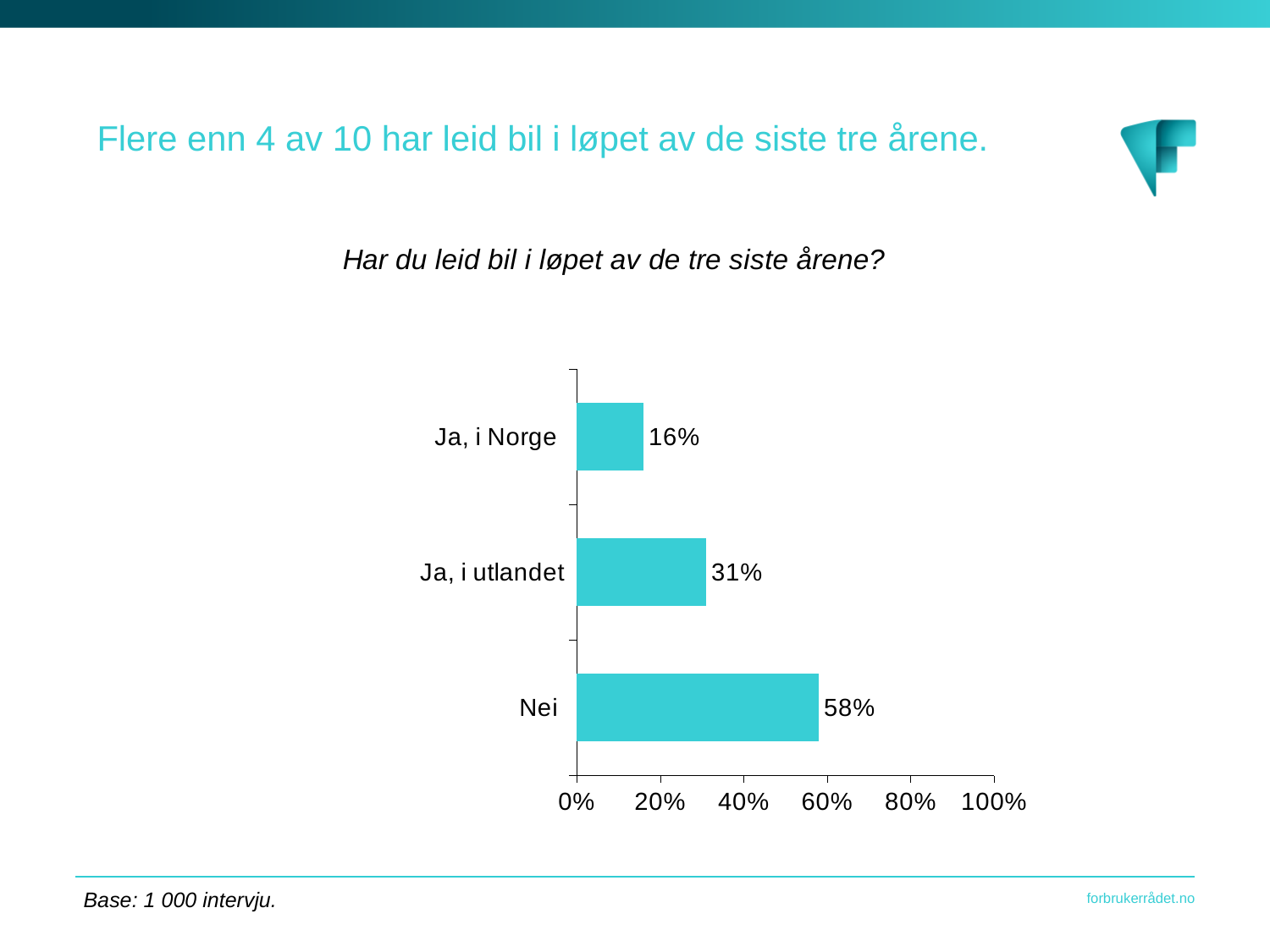
What is the value for "Nei"? 58% What kind of chart is shown on the slide? bar chart How many categories are shown in the chart? 3 What is the value for "Ja, i Norge"? 16% What question is shown as the chart's title? Har du leid bil i løpet av de tre siste årene? What is the value for "Ja, i utlandet"? 31% Which category has the highest value? Nei Which is larger, the value for "Ja, i Norge" or the value for "Ja, i utlandet"? Ja, i utlandet Is the value for "Nei" greater or less than 40%? greater What is the difference between the values for "Nei" and "Ja, i utlandet"? 27% Which category has the lowest value? Ja, i Norge What is the difference between the values for "Ja, i utlandet" and "Ja, i Norge"? 15%